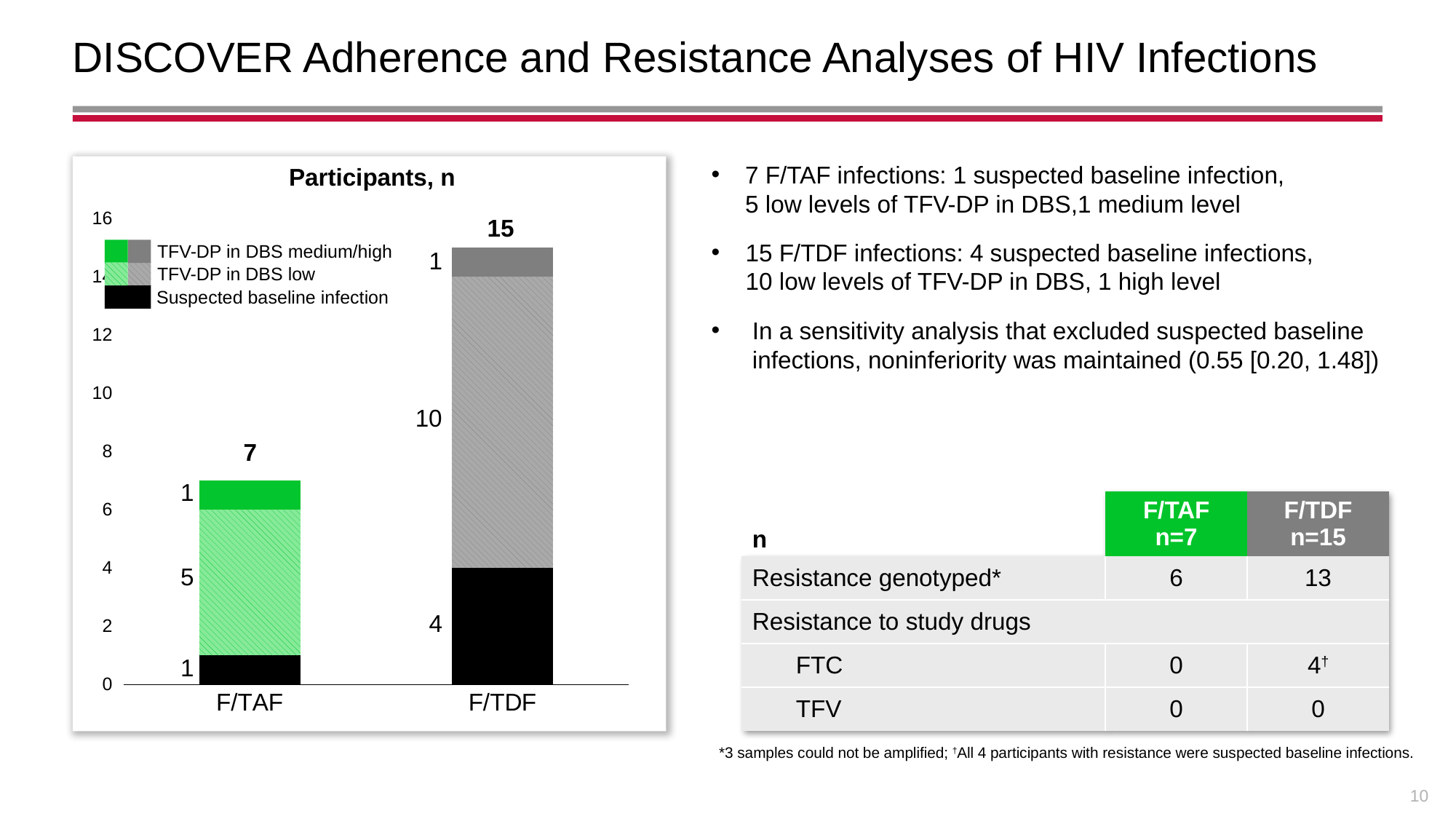
How many F/TDF participants had a suspected baseline infection? 4 What is the total number of participants shown for the F/TAF bar? 7 What is the total number of participants shown for the F/TDF bar? 15 What type of chart is shown on the slide? Stacked bar chart What is the difference in total infections between the F/TDF and F/TAF bars? 8 How many categories are shown on the x axis of the chart? 2 How many F/TAF participants had low levels of TFV-DP in DBS? 5 Which treatment group has the higher total number of participants with HIV infections? F/TDF What is the difference between the F/TDF and F/TAF counts of participants with low TFV-DP in DBS? 5 How many F/TAF participants had medium/high TFV-DP in DBS? 1 How many F/TDF participants had low levels of TFV-DP in DBS? 10 How many series does the chart legend list? 3